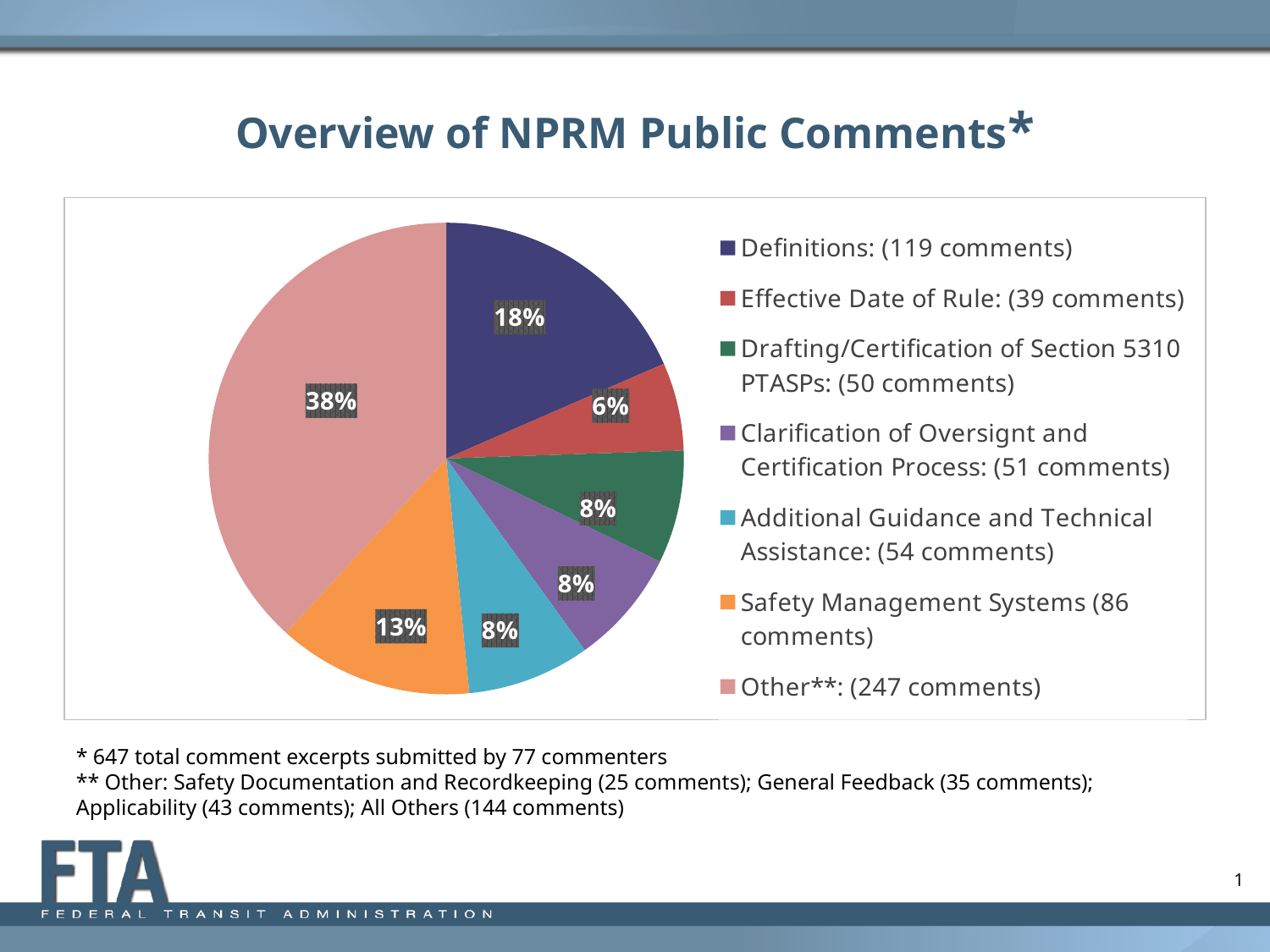
Which category has the smallest slice of the pie? Effective Date of Rule What is the difference in percentage points between the Other** slice and the Definitions slice? 20 percentage points How many slices does the pie chart have? 7 What kind of chart is shown on the slide? pie chart What share of the pie does the Effective Date of Rule slice represent? 6% What share of the pie does the Definitions slice represent? 18% Which category has the largest slice of the pie? Other** Which slice is larger: Safety Management Systems or Definitions? Definitions What is the title of the chart on the slide? Overview of NPRM Public Comments* What share of the pie does the Other** slice represent? 38% How many comments does the legend list for Additional Guidance and Technical Assistance? 54 comments